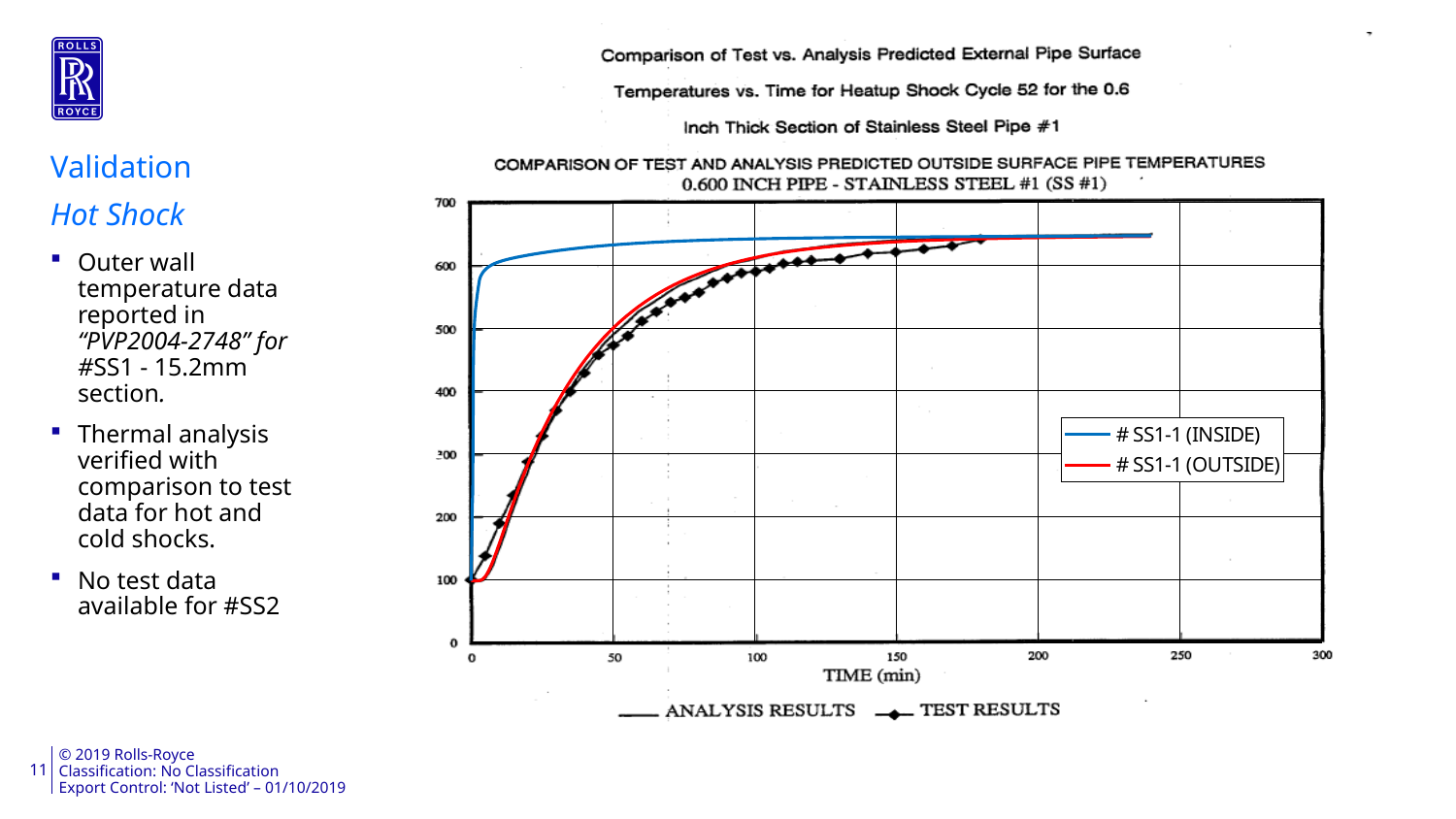
At 50 min, which series has the higher temperature, # SS1-1 (INSIDE) or # SS1-1 (OUTSIDE)? # SS1-1 (INSIDE) What kind of chart is shown on the slide? line chart Is the value of the # SS1-1 (INSIDE) curve at 50 min greater or less than 600? greater What is the highest value shown on the y axis of the chart? 700 Is the value of the # SS1-1 (OUTSIDE) curve at 150 min greater or less than 600? greater How many series does the legend box inside the plot area list? 2 Is the value of the # SS1-1 (INSIDE) curve at 100 min greater or less than 600? greater Do the temperature curves rise or fall as time increases along the x axis? rise What is the label of the x axis of the chart? TIME (min) Which colour is used for the # SS1-1 (INSIDE) series? blue